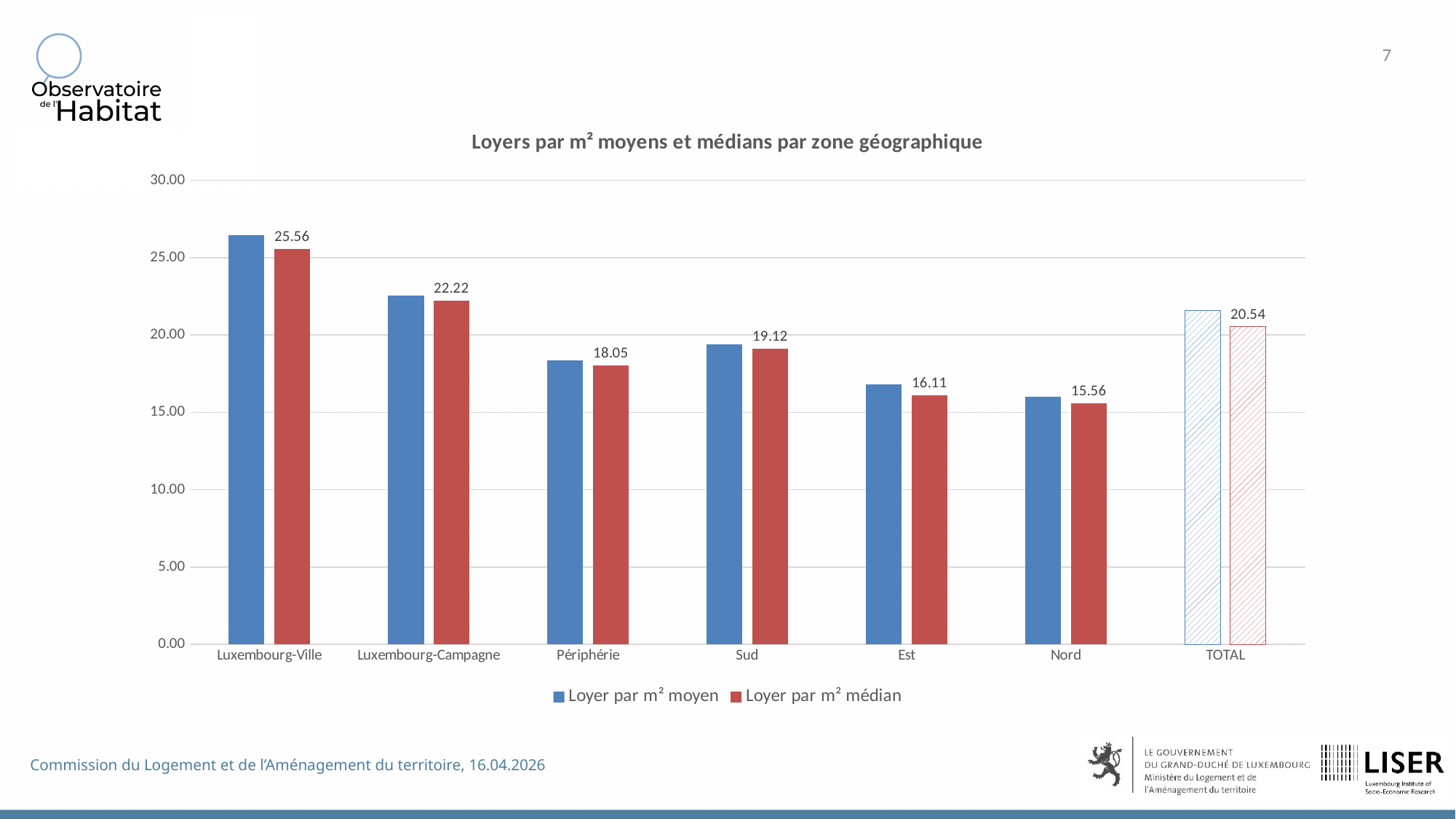
How many zones are shown on the x axis of the chart? 7 Is the Loyer par m² moyen for Luxembourg-Ville greater or less than 25.00? greater What is the difference between the Loyer par m² médian for Sud and for Périphérie? 1.07 Which zone has the lowest Loyer par m² médian? Nord Which has a higher Loyer par m² médian, Sud or Périphérie? Sud What is the value of Loyer par m² médian for TOTAL? 20.54 Is the Loyer par m² moyen for Périphérie greater or less than 20.00? less How many series does the legend list? 2 What is the value of Loyer par m² médian for Nord? 15.56 What is the difference between the Loyer par m² médian for Luxembourg-Ville and for Nord? 10.00 What is the value of Loyer par m² médian for Luxembourg-Ville? 25.56 Which zone has the highest Loyer par m² médian? Luxembourg-Ville